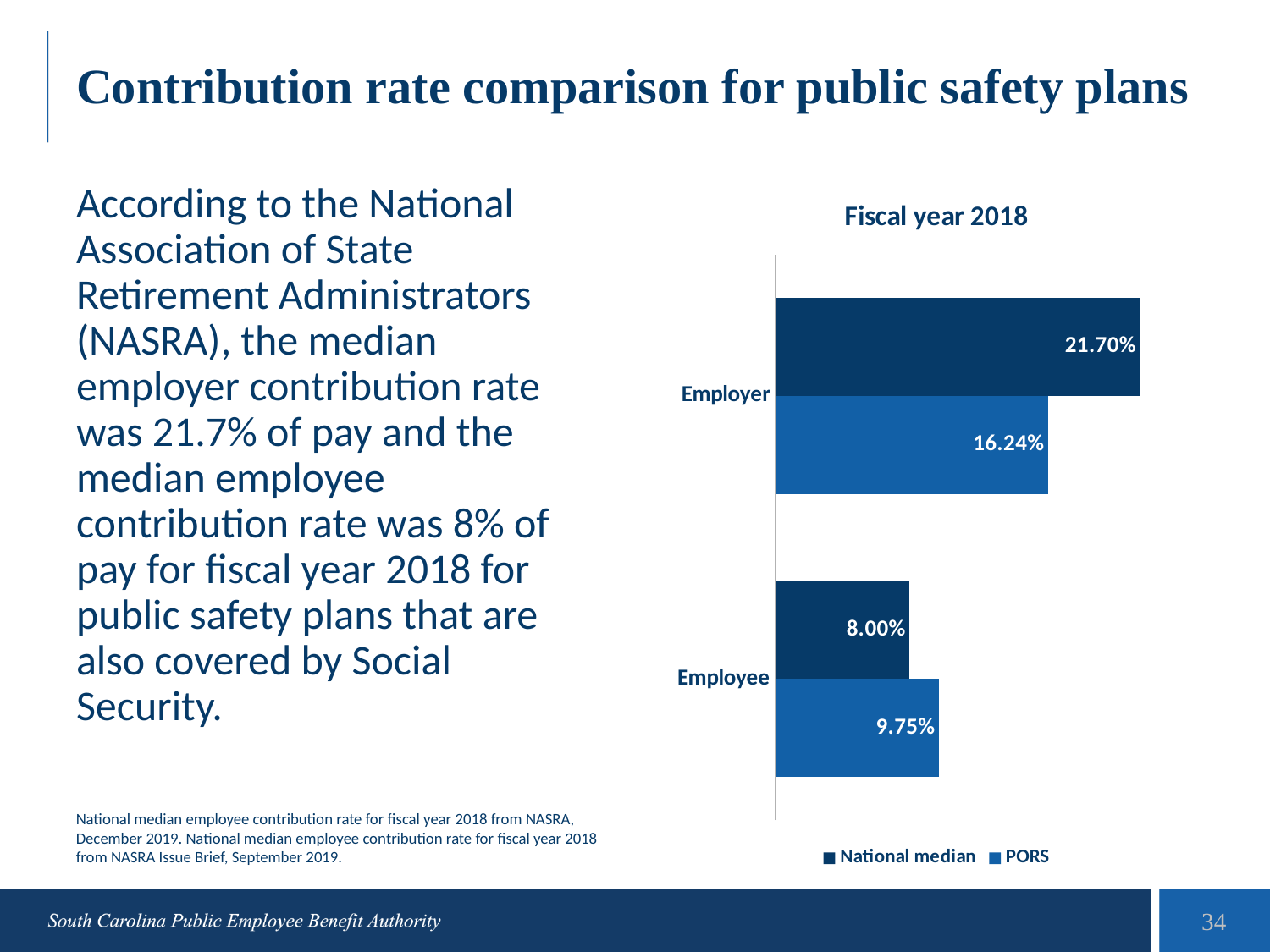
What is the National median contribution rate for Employee? 8.00% What is the difference between the PORS and National median Employee contribution rates? 1.75% What kind of chart is shown on the slide? Bar chart How many categories are shown on the chart? 2 What is the PORS contribution rate for Employer? 16.24% Which category has the highest value in the chart? Employer (National median) For Employee, which is larger: the National median or PORS rate? PORS What is the difference between the National median and PORS Employer contribution rates? 5.46% What is the PORS contribution rate for Employee? 9.75% How many series does the legend list? 2 What is the National median contribution rate for Employer? 21.70% Which bar has the lowest value in the chart? Employee (National median)